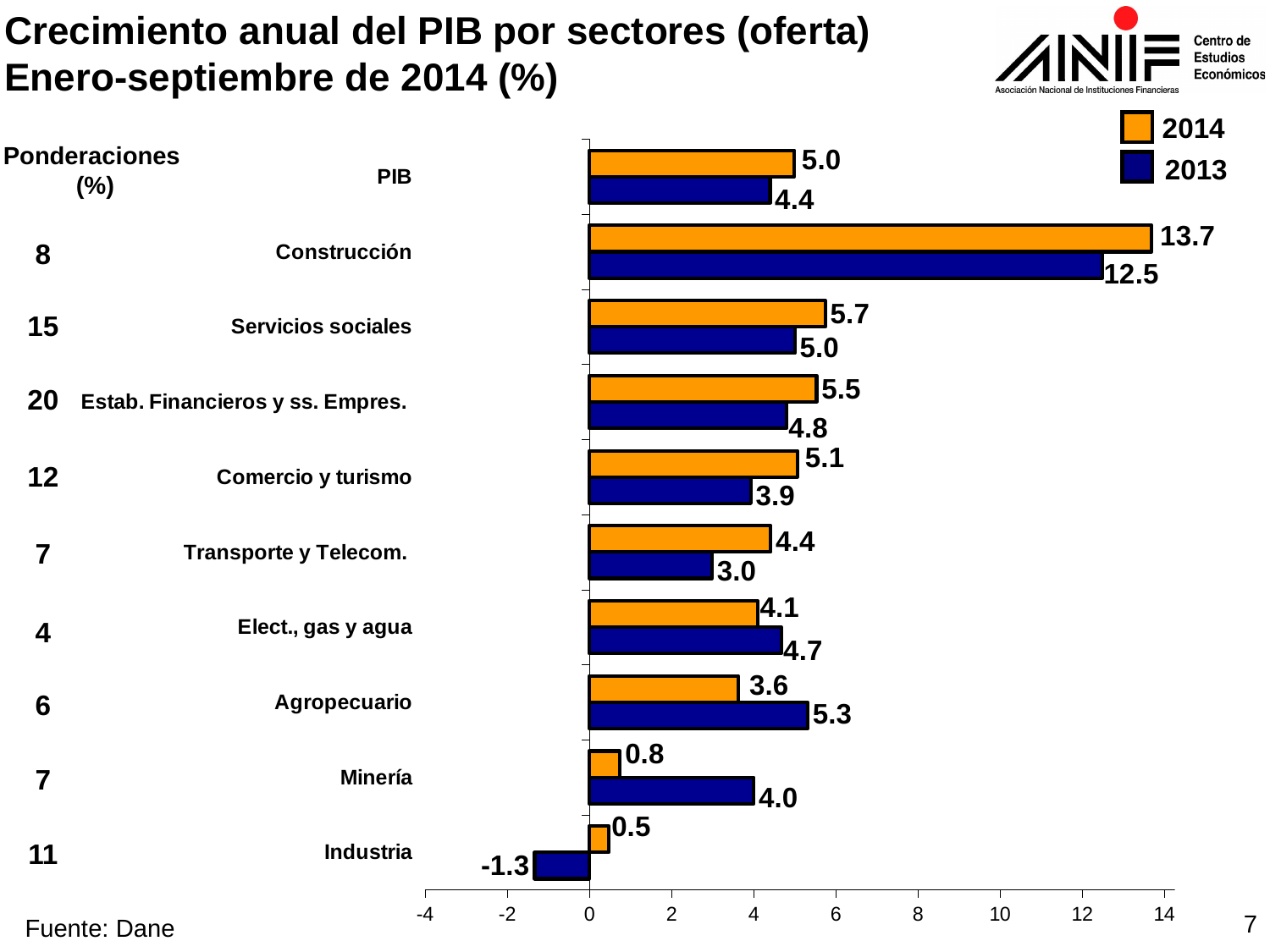
How many series does the legend list? 2 What is the 2014 value for Construcción? 13.7 Which category has the lowest 2013 value? Industria Which is larger for Elect., gas y agua: the 2014 value or the 2013 value? 2013 Which category has the highest 2014 value? Construcción How many categories are shown on the chart? 10 What is the 2013 value for Industria? -1.3 Which colour represents the 2014 series? Orange What is the 2013 value for Minería? 4.0 What is the difference between the 2013 and 2014 values for Agropecuario? 1.7 What is the difference between the 2014 and 2013 values for PIB? 0.6 What kind of chart is shown on the slide? Bar chart